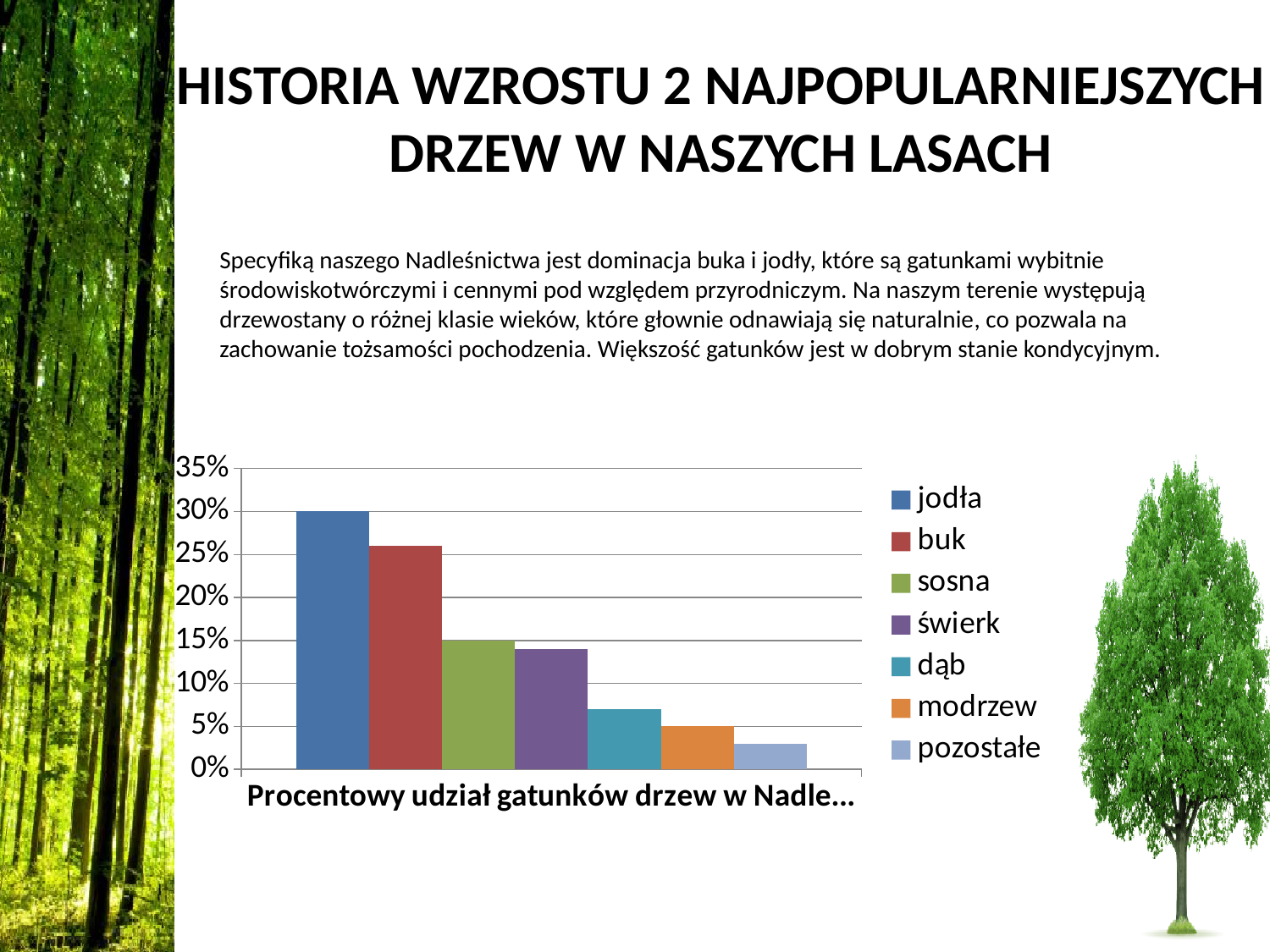
What is the highest value shown on the chart's vertical axis? 35% Which tree species has the lowest bar in the chart? pozostałe How many series does the chart legend list? 7 Do the bar values rise or fall from left to right across the chart? fall What is the value for modrzew in the chart? 5% Is the value for buk greater or less than 25%? greater Is the value for świerk greater or less than 15%? less Is the value for dąb greater or less than 10%? less Which tree species has the highest bar in the chart? jodła What is the value for jodła in the chart? 30% Which is larger, the value for sosna or the value for dąb? sosna What kind of chart is shown on the slide? bar chart